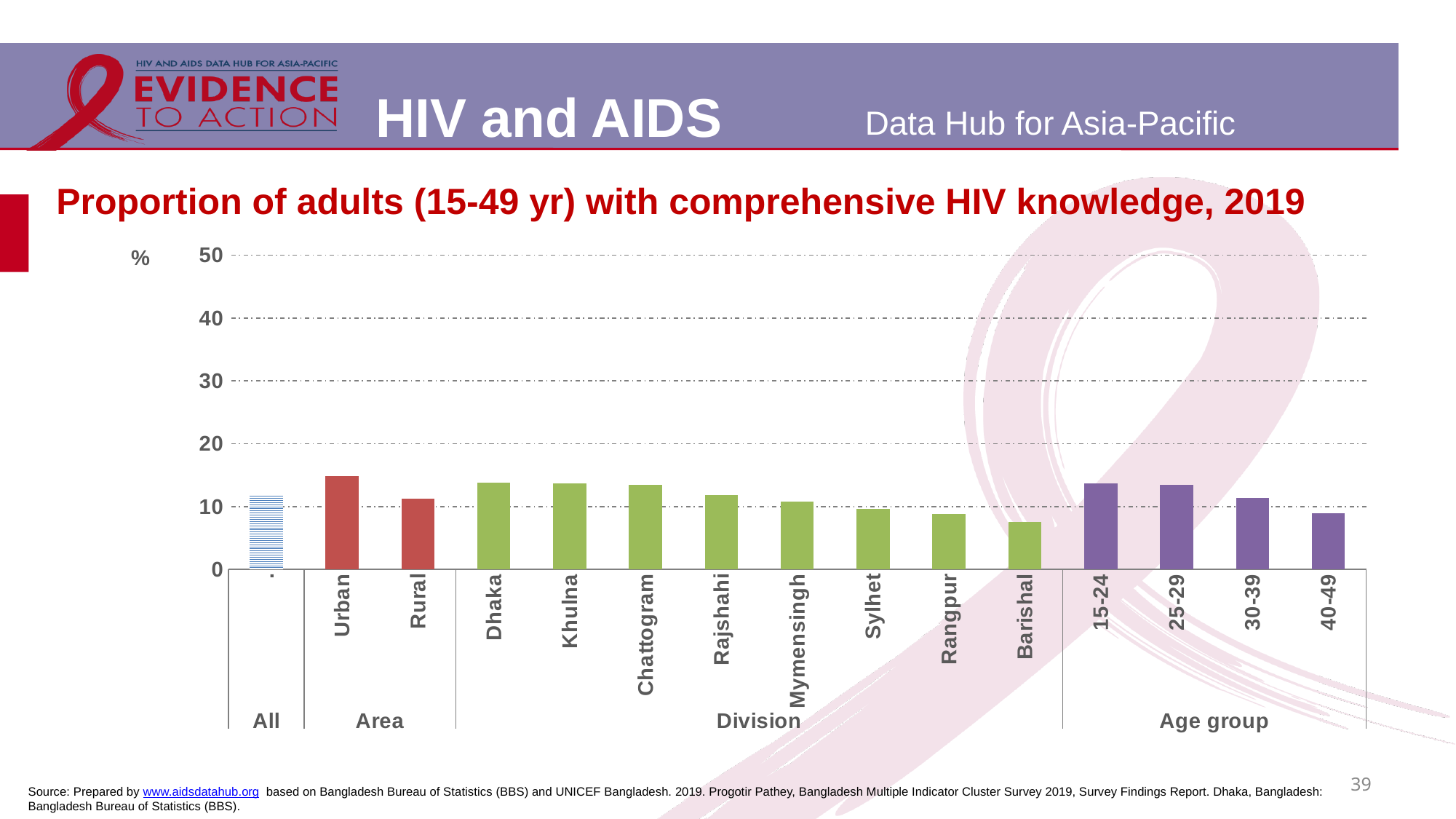
What kind of chart is shown on the slide? bar chart How many age groups are shown in the Age group section of the chart? 4 Is the value for Dhaka greater or less than 20? less Which division has the lowest proportion of adults with comprehensive HIV knowledge? Barishal Which has the higher value, Dhaka or Barishal? Dhaka Which age group has the lowest proportion of adults with comprehensive HIV knowledge? 40-49 Is the value for Urban greater or less than 10? greater Which area, Urban or Rural, has the higher proportion of adults with comprehensive HIV knowledge? Urban How many divisions are shown in the Division group of the chart? 8 Do the values rise or fall across the age groups from 15-24 to 40-49? fall Is the value for Barishal greater or less than 10? less What is the title of the chart? Proportion of adults (15-49 yr) with comprehensive HIV knowledge, 2019